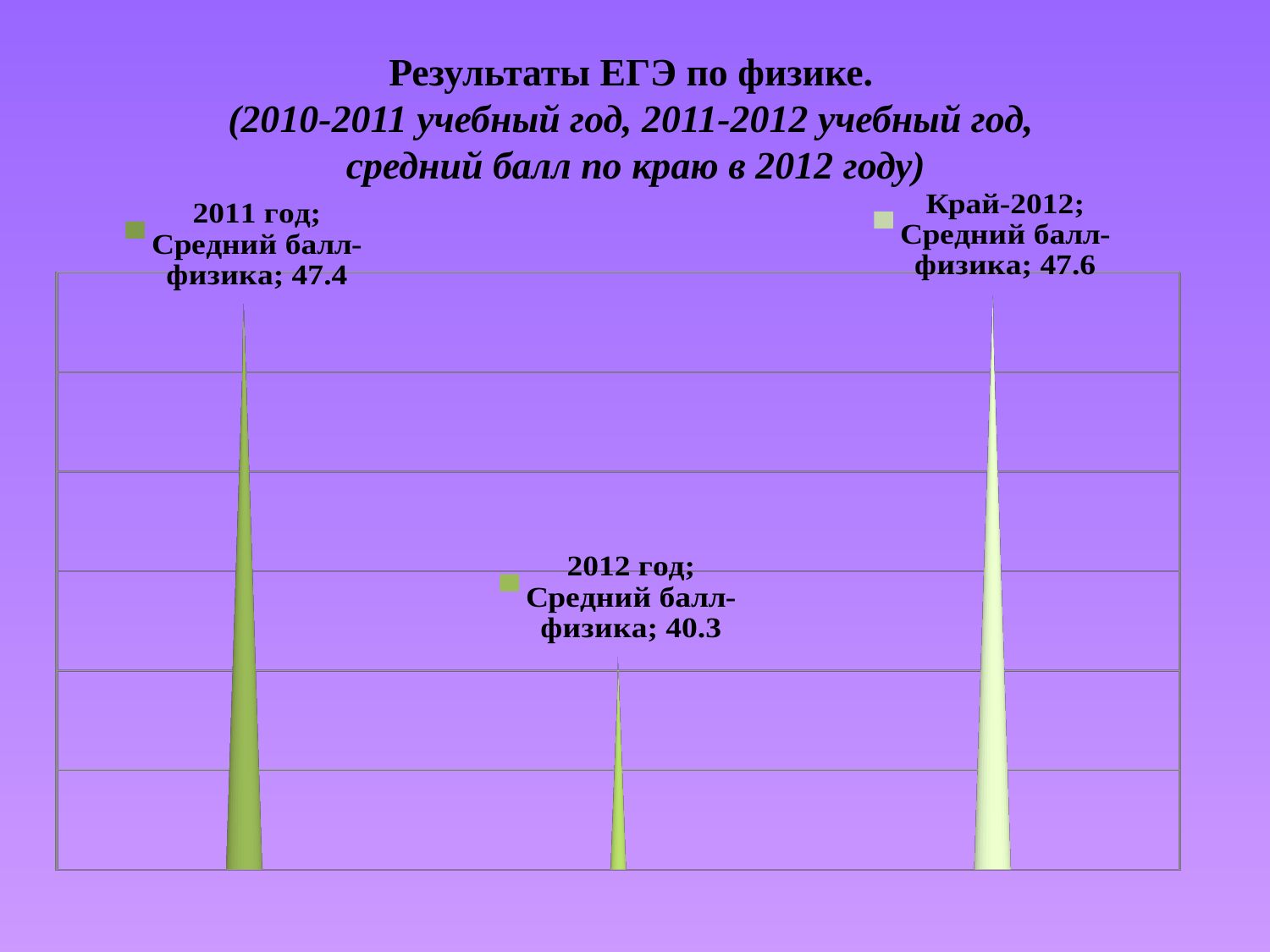
What is the average physics score for Край-2012? 47.6 Which category has the lowest average physics score? 2012 год How many categories are plotted in the chart? 3 What is the title of the chart on the slide? Результаты ЕГЭ по физике. What is the average physics score (Средний балл-физика) for 2011 год? 47.4 What is the difference between the average physics score for 2011 год and for 2012 год? 7.1 Which is larger: the average physics score for 2011 год or for 2012 год? 2011 год What kind of chart is shown on the slide? Bar chart What is the difference between the average physics score for Край-2012 and for 2011 год? 0.2 What is the difference between the average physics score for Край-2012 and for 2012 год? 7.3 What is the average physics score for 2012 год? 40.3 Which category has the highest average physics score? Край-2012